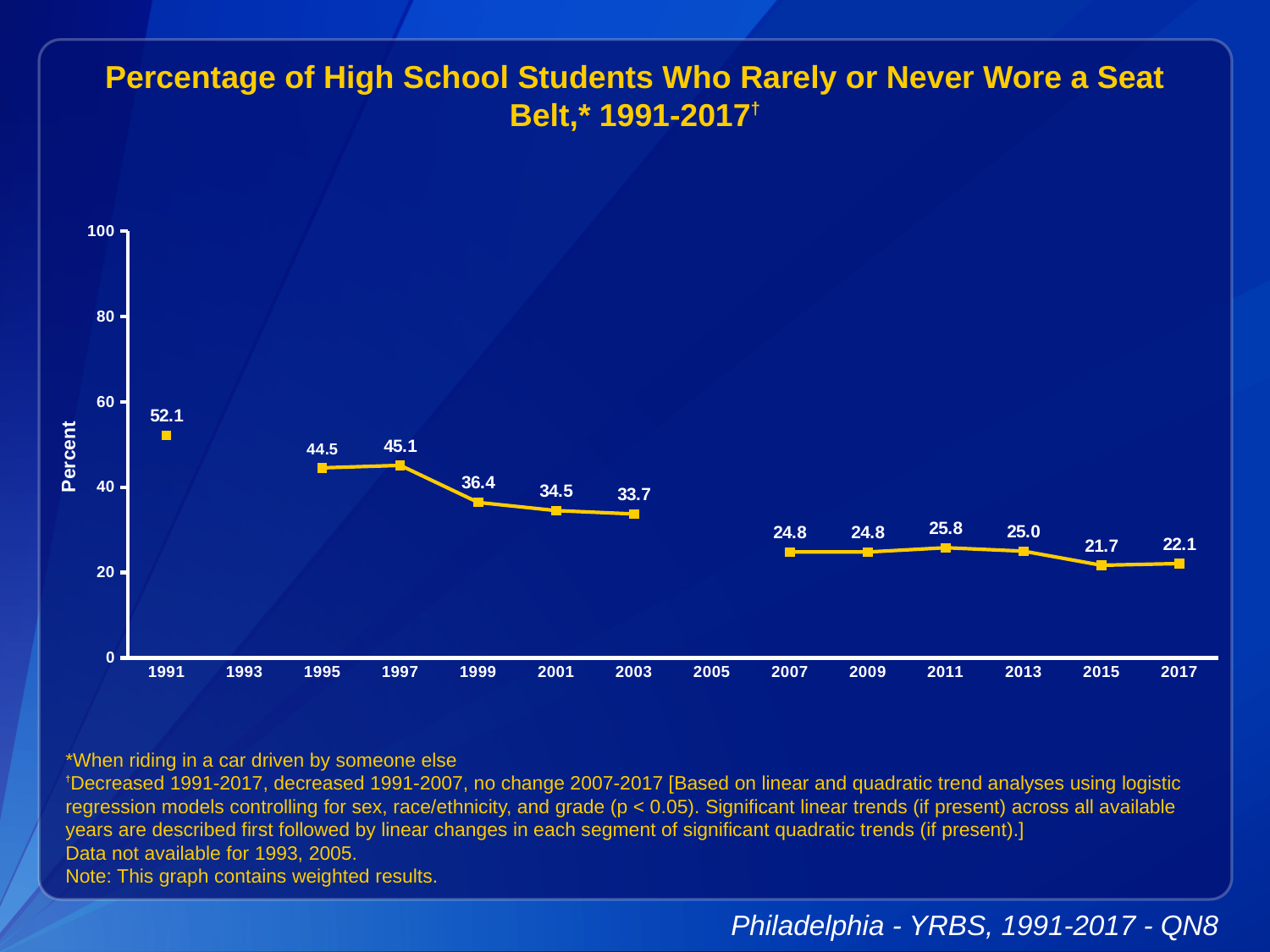
How many data points are plotted on the chart? 12 What is the difference between the 1991 value and the 2017 value? 30.0 Which year has the lowest percentage? 2015 What value is shown for 2017? 22.1 What value is shown for 1999? 36.4 Do the values generally rise or fall from 1991 to 2017? fall Which is larger, the value for 1997 or the value for 1995? 1997 Which year has the highest percentage? 1991 Is the value for 2003 greater or less than 40? less What is the label on the y axis? Percent What kind of chart is this? line chart What was the percentage of high school students who rarely or never wore a seat belt in 1991? 52.1